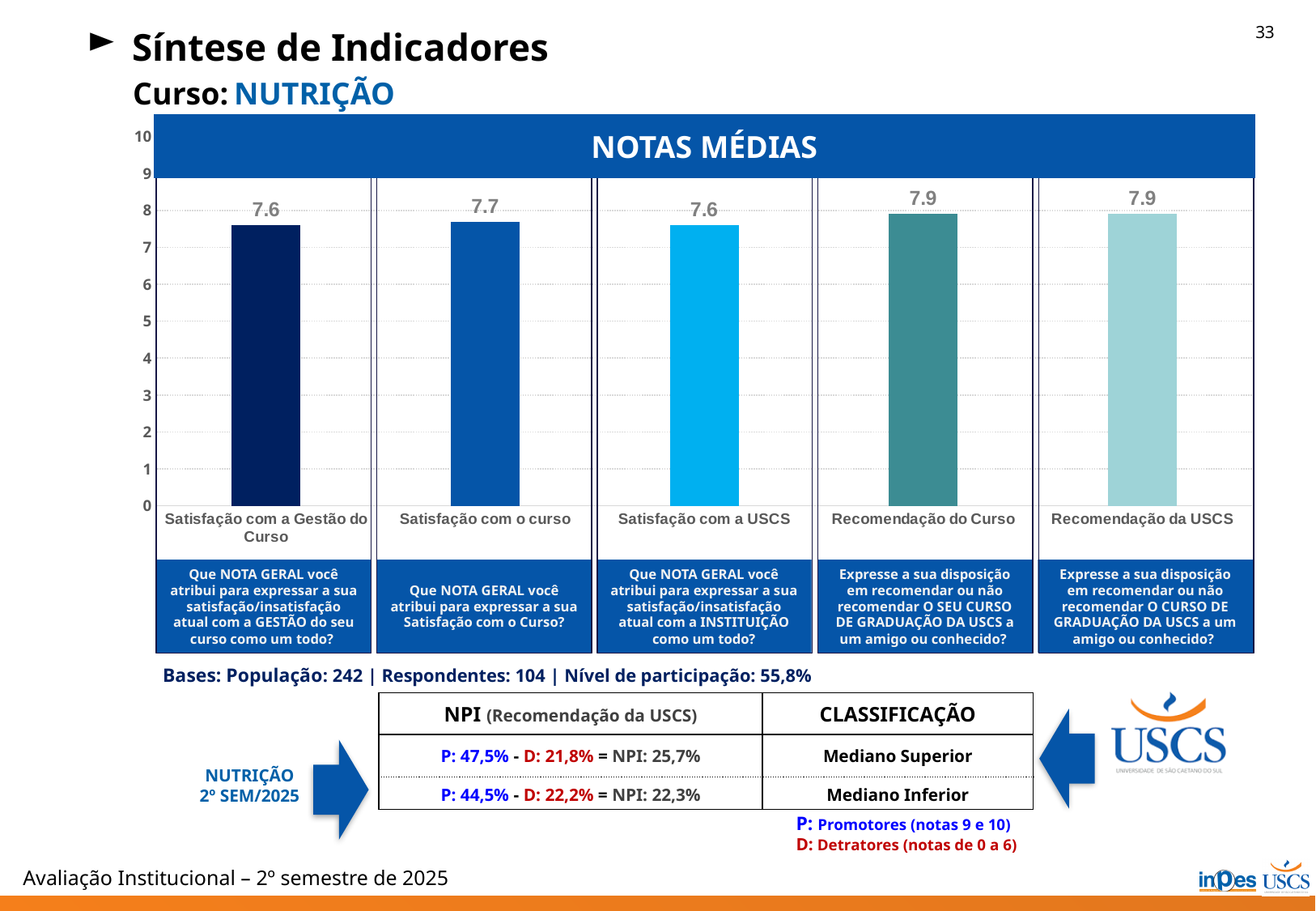
How many categories (bars) are shown in the chart? 5 What is the lowest value shown in the chart? 7.6 What is the highest value shown in the chart? 7.9 What is the value for Satisfação com o curso? 7.7 What is the value for Recomendação do Curso? 7.9 Which is larger, the value for Recomendação da USCS or the value for Satisfação com o curso? Recomendação da USCS What kind of chart is shown on the slide? bar chart What is the value for Recomendação da USCS? 7.9 What is the value for Satisfação com a Gestão do Curso? 7.6 Is the value for Satisfação com a USCS greater or less than 7? greater What is the difference between the values for Recomendação do Curso and Satisfação com a USCS? 0.3 What is the title of the chart? NOTAS MÉDIAS